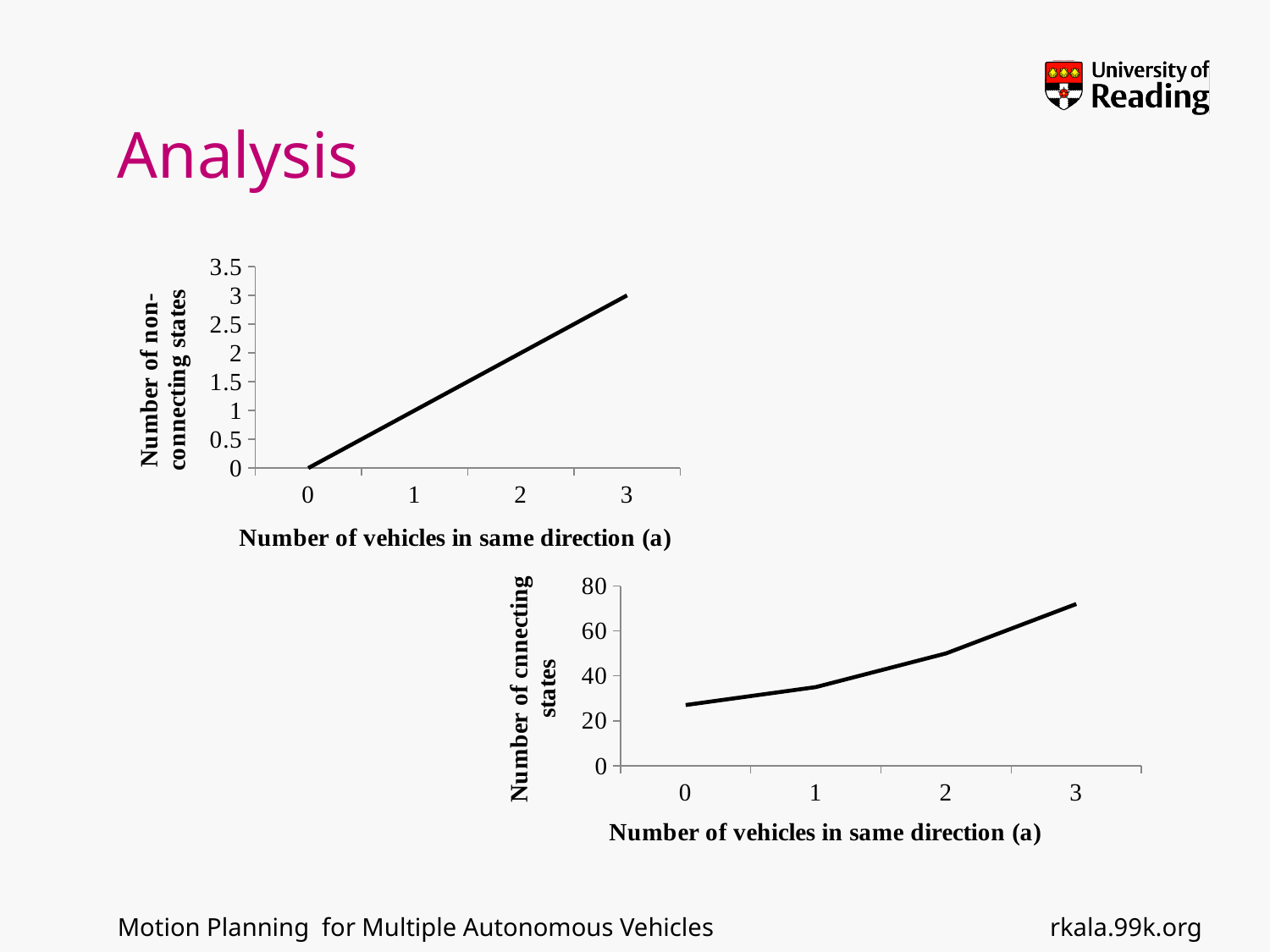
In the top chart (Number of non-connecting states), do the values rise or fall as the number of vehicles increases? rise In the bottom chart (Number of connecting states), do the values rise or fall as the number of vehicles increases? rise What type of chart is the bottom chart on the slide? line chart In the top chart (Number of non-connecting states), what is the value when the number of vehicles in same direction is 3? 3 In the bottom chart (Number of connecting states), is the value at 3 vehicles greater or less than 60? greater What type of chart is the top chart on the slide? line chart In the bottom chart (Number of connecting states), which number of vehicles has the highest value? 3 In the top chart (Number of non-connecting states), what is the value when the number of vehicles in same direction is 0? 0 What is the x-axis title of the bottom chart? Number of vehicles in same direction (a) In the bottom chart (Number of connecting states), is the value at 0 vehicles greater or less than 40? less In the bottom chart (Number of connecting states), is the value at 1 vehicle greater or less than 20? greater In the top chart (Number of non-connecting states), how many x-axis categories are shown? 4